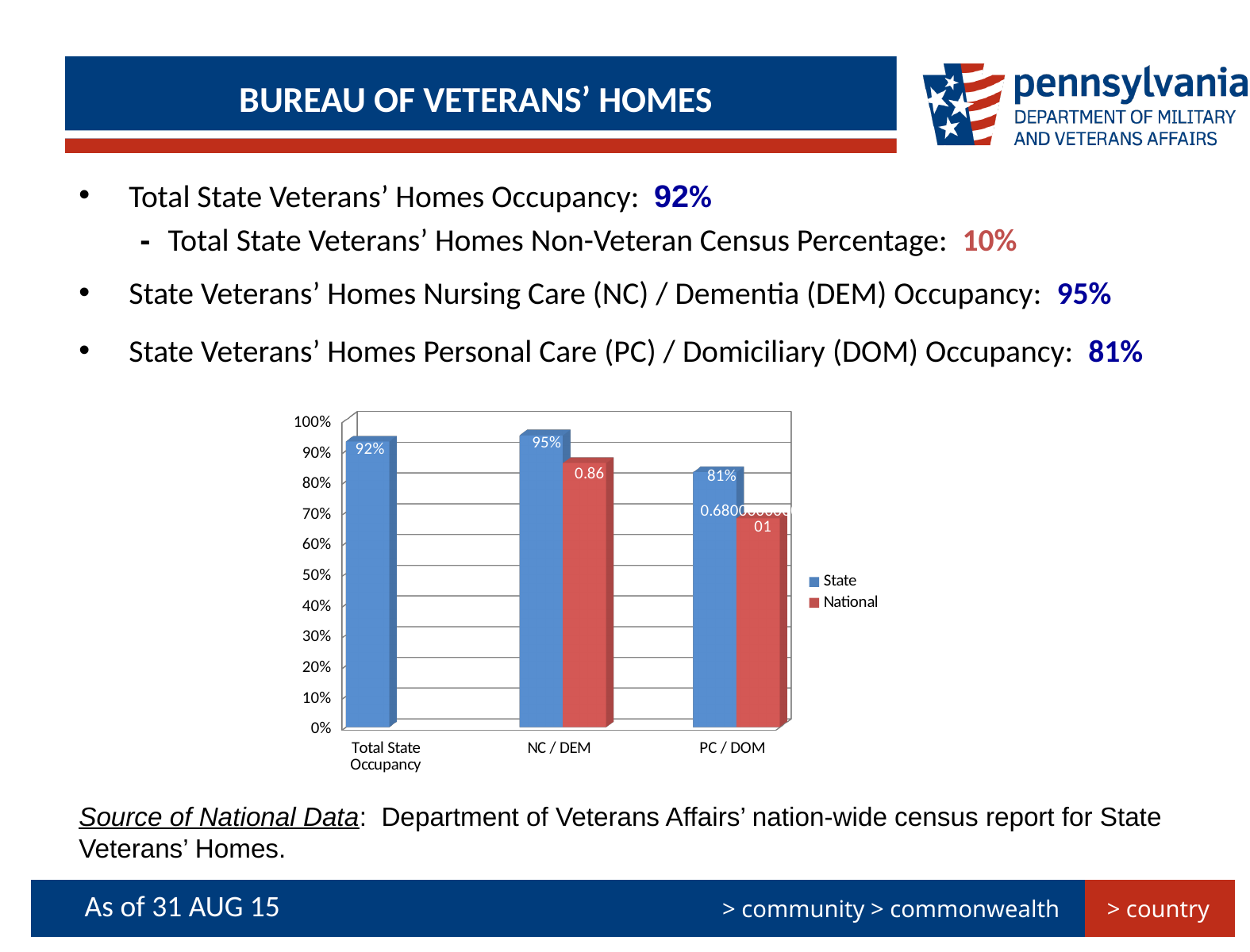
What is the difference between the State values for NC / DEM and PC / DOM? 14 percentage points What is the data label on the National bar for NC / DEM? 0.86 Which category has the lowest State value? PC / DOM For NC / DEM, which is larger, the State bar or the National bar? State Which category has the highest State value? NC / DEM What kind of chart is shown on the slide? Bar chart What is the State value for NC / DEM? 95% How many categories are shown on the x axis? 3 What is the State value for PC / DOM? 81% What is the State value for Total State Occupancy? 92% How many series does the legend list? 2 Is the National value for PC / DOM greater or less than 70%? less